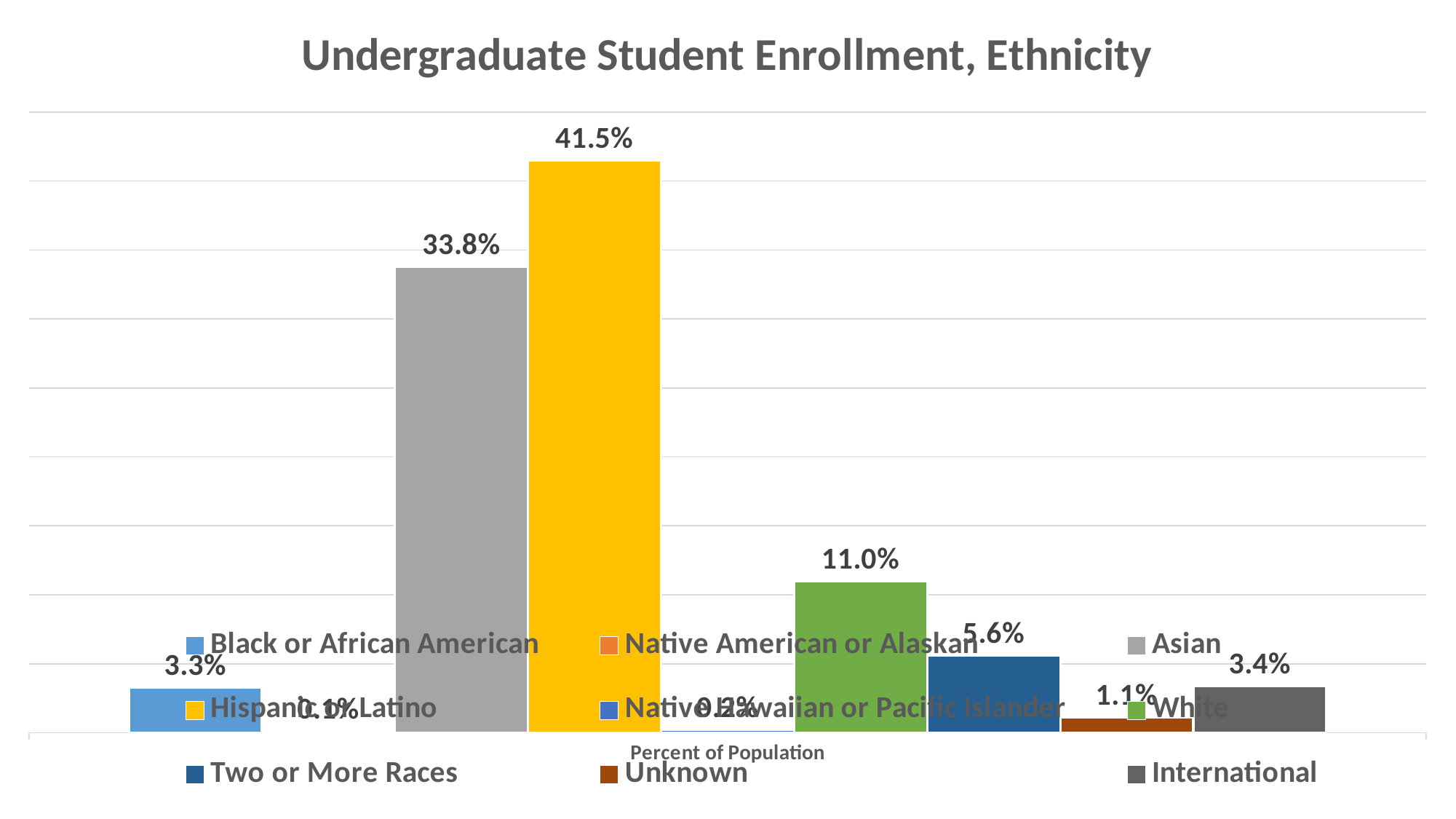
What kind of chart is shown? Bar chart What is the value for Two or More Races? 5.6% What is the title of the chart? Undergraduate Student Enrollment, Ethnicity What is the value for White? 11.0% What is the value for Unknown? 1.1% What is the difference between the Hispanic or Latino value and the Asian value? 7.7% How many entries does the legend list? 9 Which is larger, the value for White or the value for Two or More Races? White What is the value for Asian? 33.8% What is the value for International? 3.4% Which category has the highest value? Hispanic or Latino What is the value for Hispanic or Latino? 41.5%